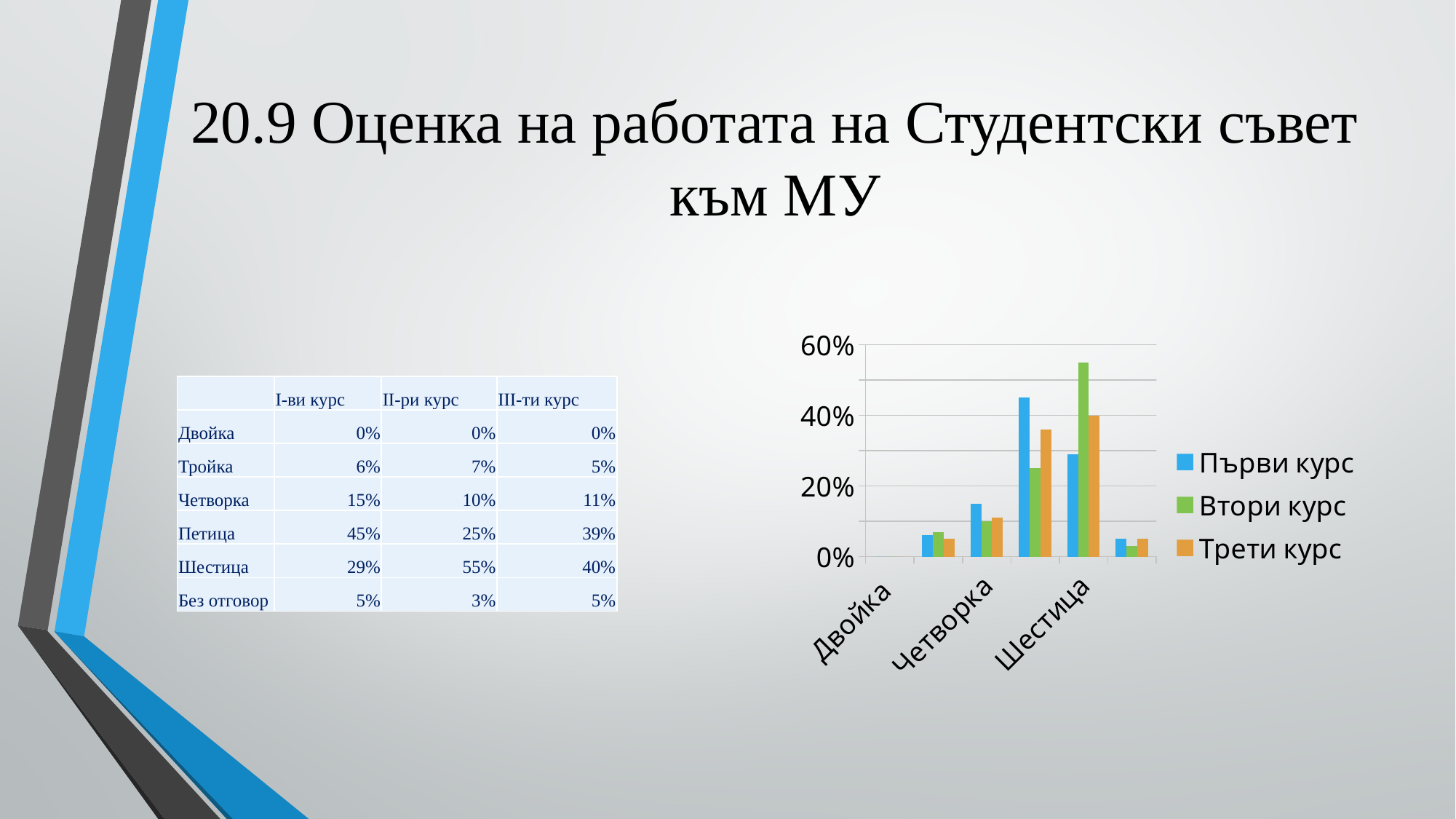
What is the difference between the Шестица values for II-ри курс and I-ви курс as printed in the table? 26% Which series has the highest bar for Петица? Първи курс Which series has the highest bar for Шестица? Втори курс For Петица, which is larger: the bar for Първи курс or the bar for Втори курс? Първи курс Is the value for Втори курс at Шестица greater or less than 40%? greater Is the value for Трети курс at Петица greater or less than 20%? greater According to the table on the slide, what is the value for Шестица for II-ри курс? 55% What kind of chart is shown on the slide? bar chart According to the table on the slide, what is the value for Петица for I-ви курс? 45% Is the value for Първи курс at Четворка greater or less than 20%? less How many series does the chart legend list? 3 How many category groups of bars are plotted in the chart? 6